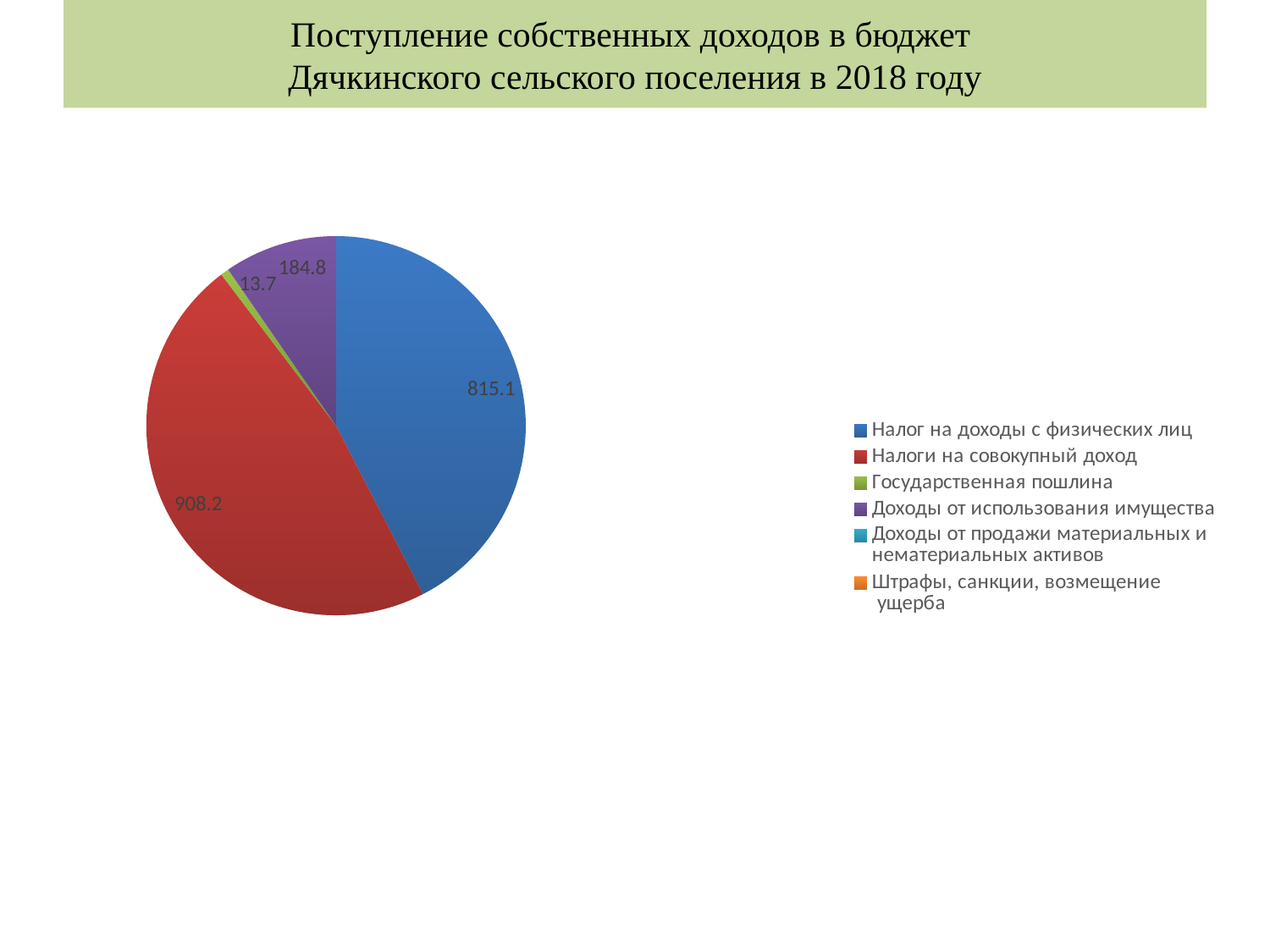
What is the value for Налоги на совокупный доход? 908.2 What is the difference between the values for Налоги на совокупный доход and Налог на доходы с физических лиц? 93.1 What colour is the slice for Налоги на совокупный доход? Red Which is larger: the value for Налог на доходы с физических лиц or the value for Доходы от использования имущества? Налог на доходы с физических лиц What is the value for Налог на доходы с физических лиц? 815.1 Which category has the smallest printed value on the pie? Государственная пошлина What is the difference between the values for Доходы от использования имущества and Государственная пошлина? 171.1 What is the value for Доходы от использования имущества? 184.8 How many categories does the legend list? 6 What is the value for Государственная пошлина? 13.7 Which category has the largest slice of the pie? Налоги на совокупный доход What kind of chart is shown on the slide? Pie chart